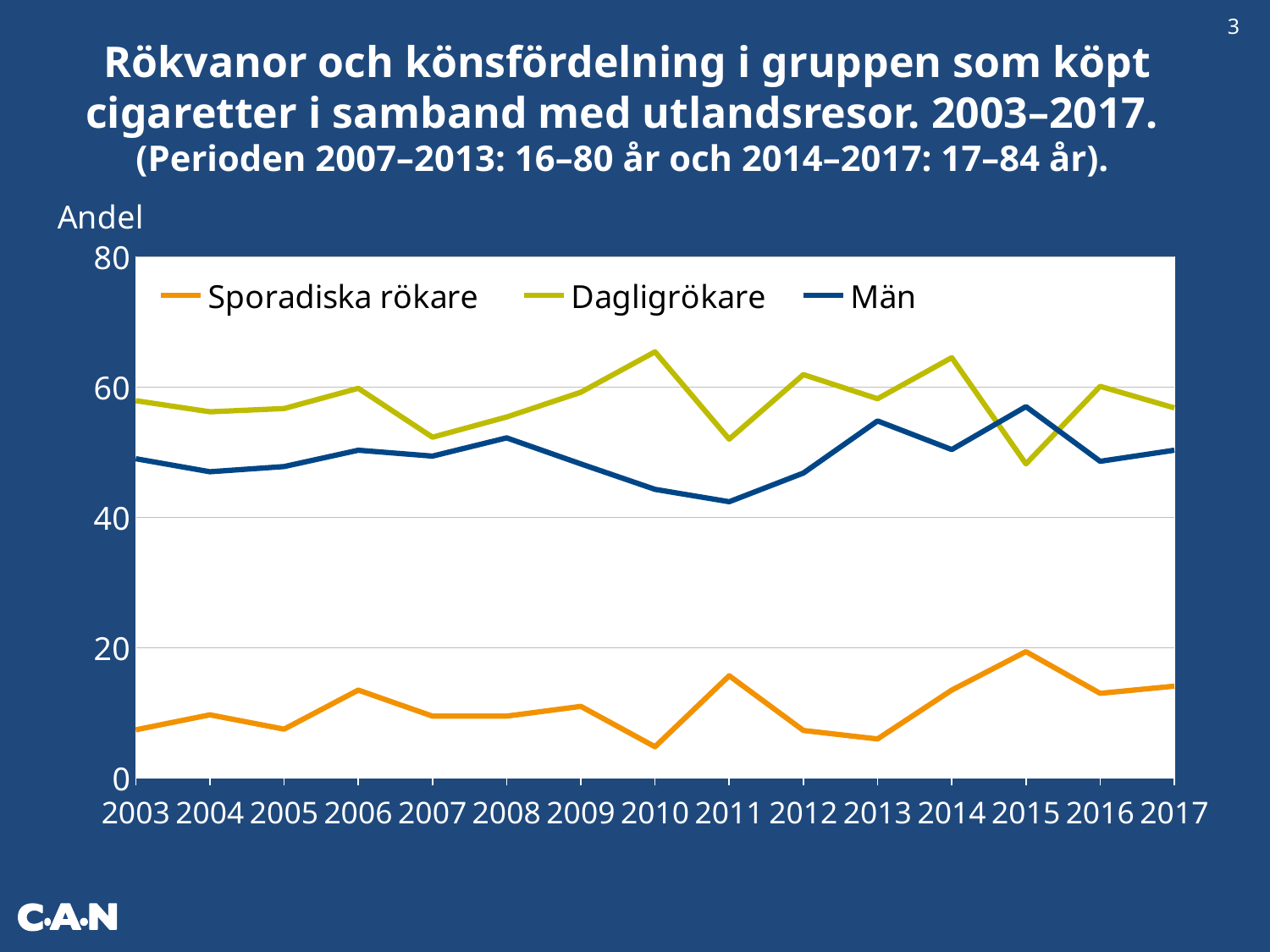
In which year is the value for Män lowest? 2011 In 2003, which is larger: the value for Dagligrökare or the value for Män? Dagligrökare What label is shown on the y axis of the chart? Andel In which year is the value for Sporadiska rökare highest? 2015 In 2015, which is larger: the value for Dagligrökare or the value for Män? Män Is the value for Dagligrökare in 2015 greater or less than 60? less In which year is the value for Dagligrökare lowest? 2015 How many series does the legend list? 3 What kind of chart is shown on the slide? Line chart How many years are shown on the x axis? 15 Is the value for Dagligrökare in 2010 greater or less than 60? greater